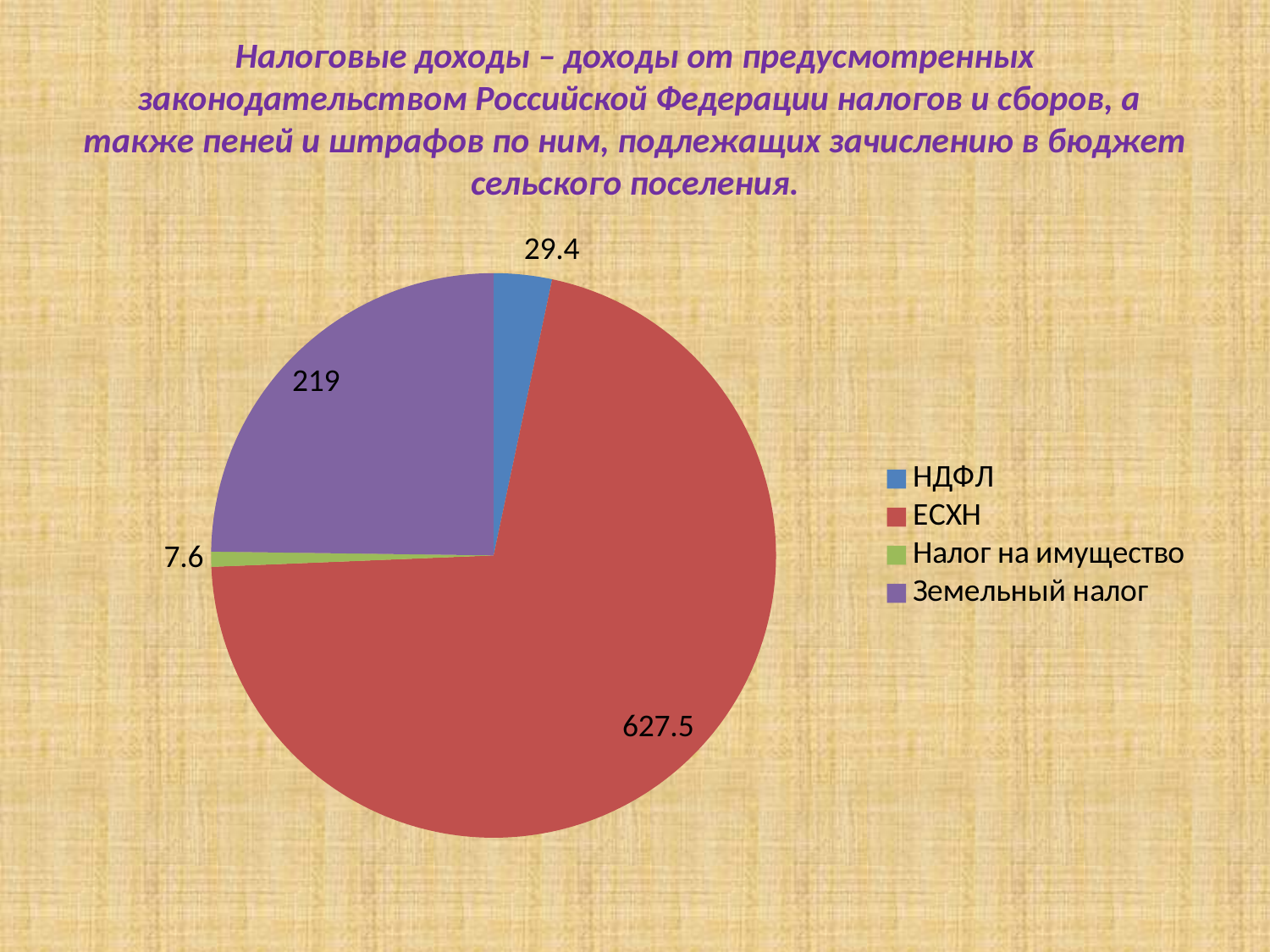
What is the value for ЕСХН? 627.5 What is the difference between the values for ЕСХН and Земельный налог? 408.5 Which category has the smallest slice of the pie? Налог на имущество What type of chart is shown on the slide? pie chart What is the value for Налог на имущество? 7.6 How many categories does the pie chart have? 4 What is the value for Земельный налог? 219 What colour is the slice for Земельный налог? purple What is the difference between the values for НДФЛ and Налог на имущество? 21.8 What is the value for НДФЛ? 29.4 Which is larger, the value for Земельный налог or the value for НДФЛ? Земельный налог Which category has the largest slice of the pie? ЕСХН